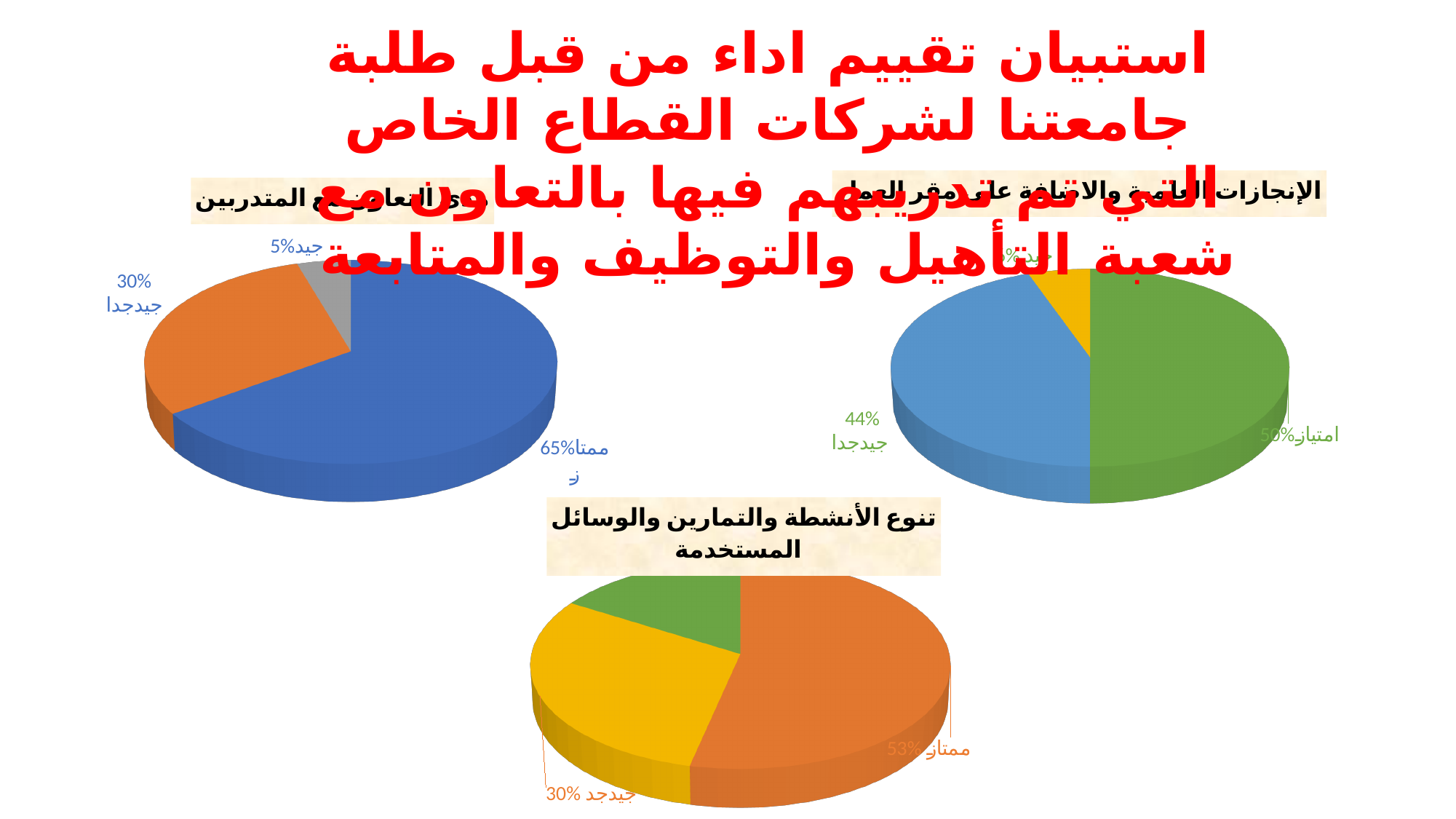
In the left pie chart, what share is labelled ممتاز? 65% In the left pie chart, which category has the smallest slice? جيد What kind of charts are shown on the slide? Pie charts In the left pie chart, what share is labelled جيد? 5% In the bottom pie chart titled تنوع الأنشطة والتمارين والوسائل المستخدمة, which is larger: the ممتاز slice or the جيدجد slice? ممتاز In the right pie chart, what share is labelled جيدجدا? 44% How many pie charts are on the slide? 3 In the right pie chart, what share is labelled امتياز? 50% In the left pie chart, which category has the largest slice? ممتاز In the bottom pie chart titled تنوع الأنشطة والتمارين والوسائل المستخدمة, what share is labelled ممتاز? 53% In the left pie chart, what share is labelled جيدجدا? 30% In the left pie chart, what is the difference between the ممتاز share and the جيدجدا share? 35%